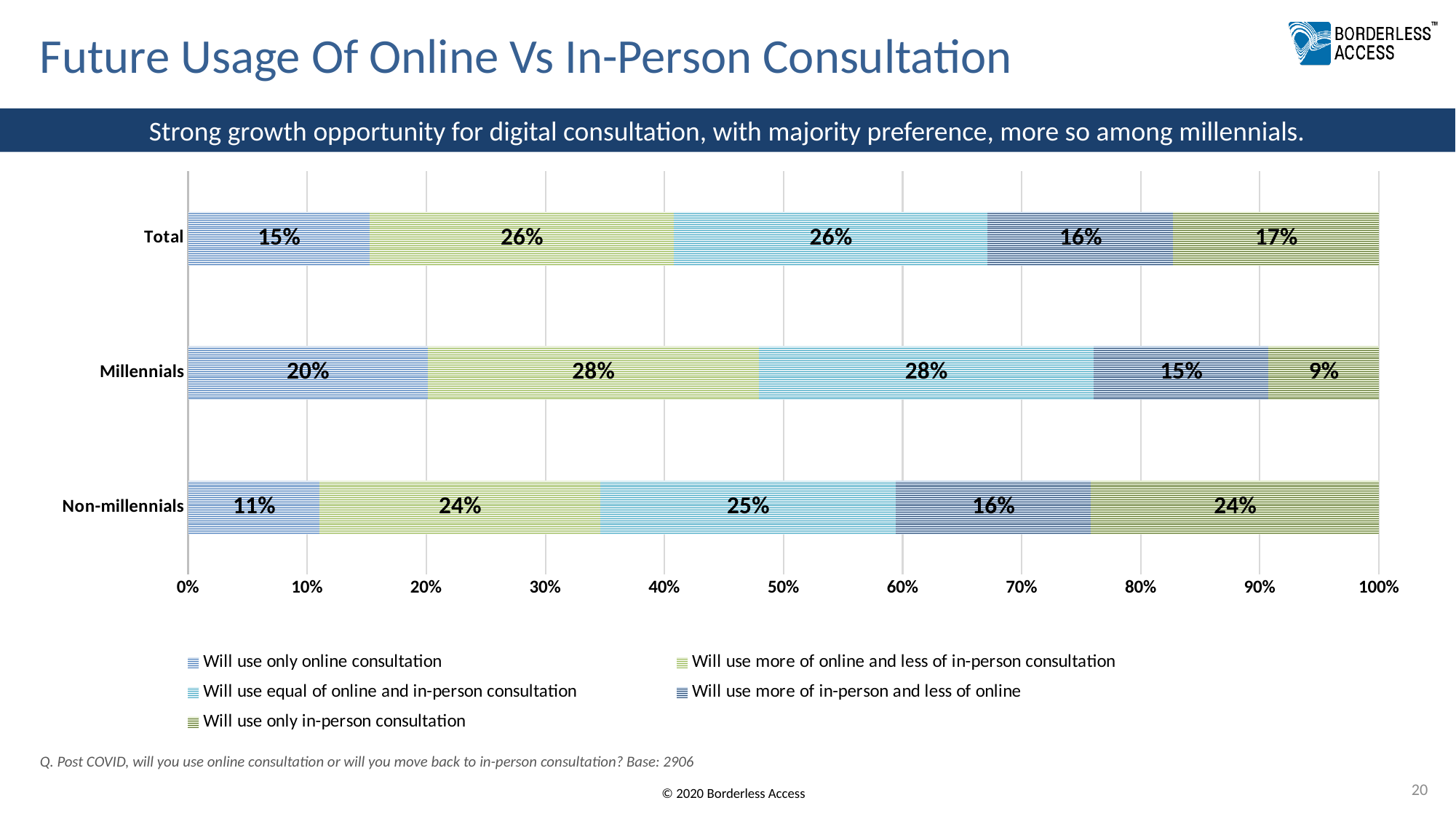
How many groups (categories) are shown on the chart? 3 Which group has the highest value for 'Will use only online consultation'? Millennials What kind of chart is shown on the slide? Stacked bar chart What is the combined share of Millennials who will use only online consultation or more of online and less of in-person consultation? 48% What percentage of Non-millennials will use only in-person consultation? 24% What is the Total value for 'Will use equal of online and in-person consultation'? 26% How many series does the legend list? 5 Which group has the lowest value for 'Will use only in-person consultation'? Millennials What is the title of the slide containing the chart? Future Usage Of Online Vs In-Person Consultation What percentage of Millennials will use only online consultation? 20% Which is larger: the Total value for 'Will use only in-person consultation' or the Total value for 'Will use more of in-person and less of online'? Will use only in-person consultation What is the difference between Millennials and Non-millennials for 'Will use only online consultation'? 9%